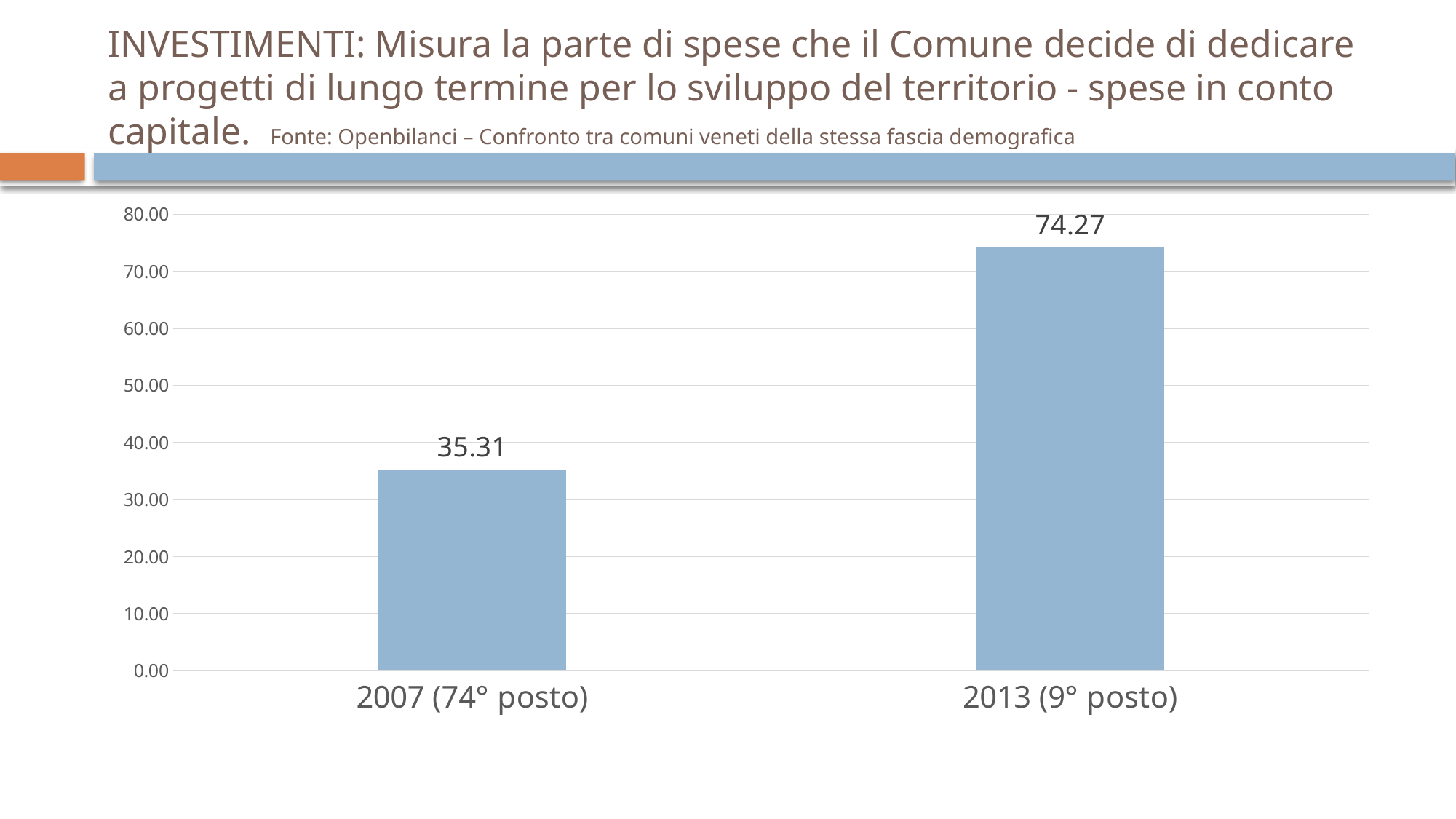
Do the values rise or fall from 2007 to 2013? rise Is the value for 2007 (74° posto) greater or less than 40.00? less What is the value for 2013 (9° posto)? 74.27 What is the value for 2007 (74° posto)? 35.31 Which category has the highest value? 2013 (9° posto) What is the difference between the values for 2013 (9° posto) and 2007 (74° posto)? 38.96 Which category has the lowest value? 2007 (74° posto) Which is larger, the value for 2007 (74° posto) or the value for 2013 (9° posto)? 2013 (9° posto) What is the highest value shown on the vertical axis? 80.00 How many categories are shown on the chart? 2 What kind of chart is shown on the slide? bar chart Is the value for 2013 (9° posto) greater or less than 70.00? greater